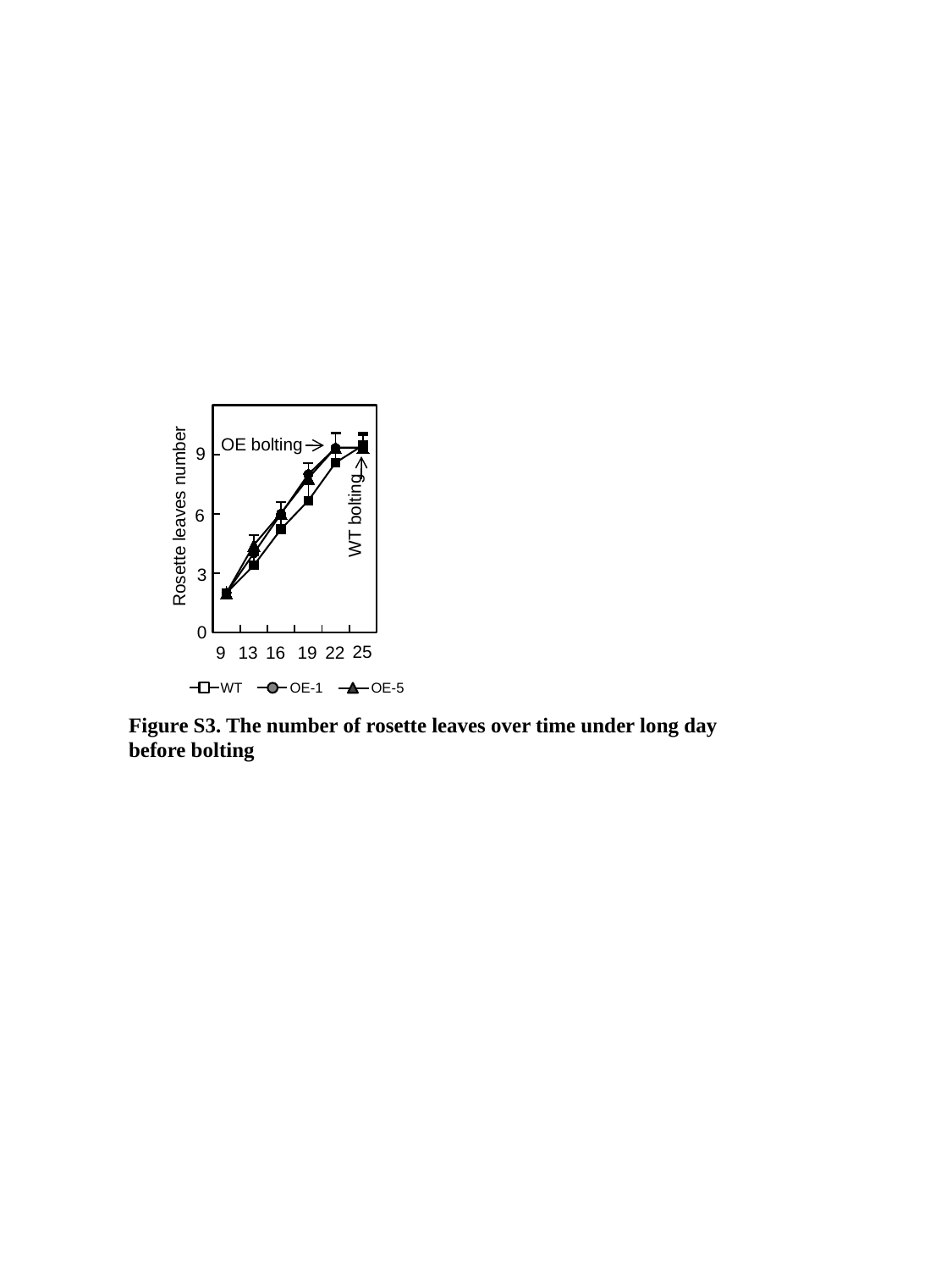
Do the rosette leaf numbers rise or fall along the x axis for the WT series? rise Is the value for OE-1 at day 19 greater or less than 6? greater At day 19, which series has the lowest value? WT At day 19, which series has the larger value, WT or OE-1? OE-1 How many time points are plotted along the x axis? 6 What is the label of the y axis? Rosette leaves number Is the value for WT at day 9 greater or less than 3? less What annotation is placed at the day 22 point on the chart? OE bolting How many series does the legend list? 3 Is the value for OE-5 at day 13 greater or less than 3? greater What kind of chart is shown on the slide? line chart